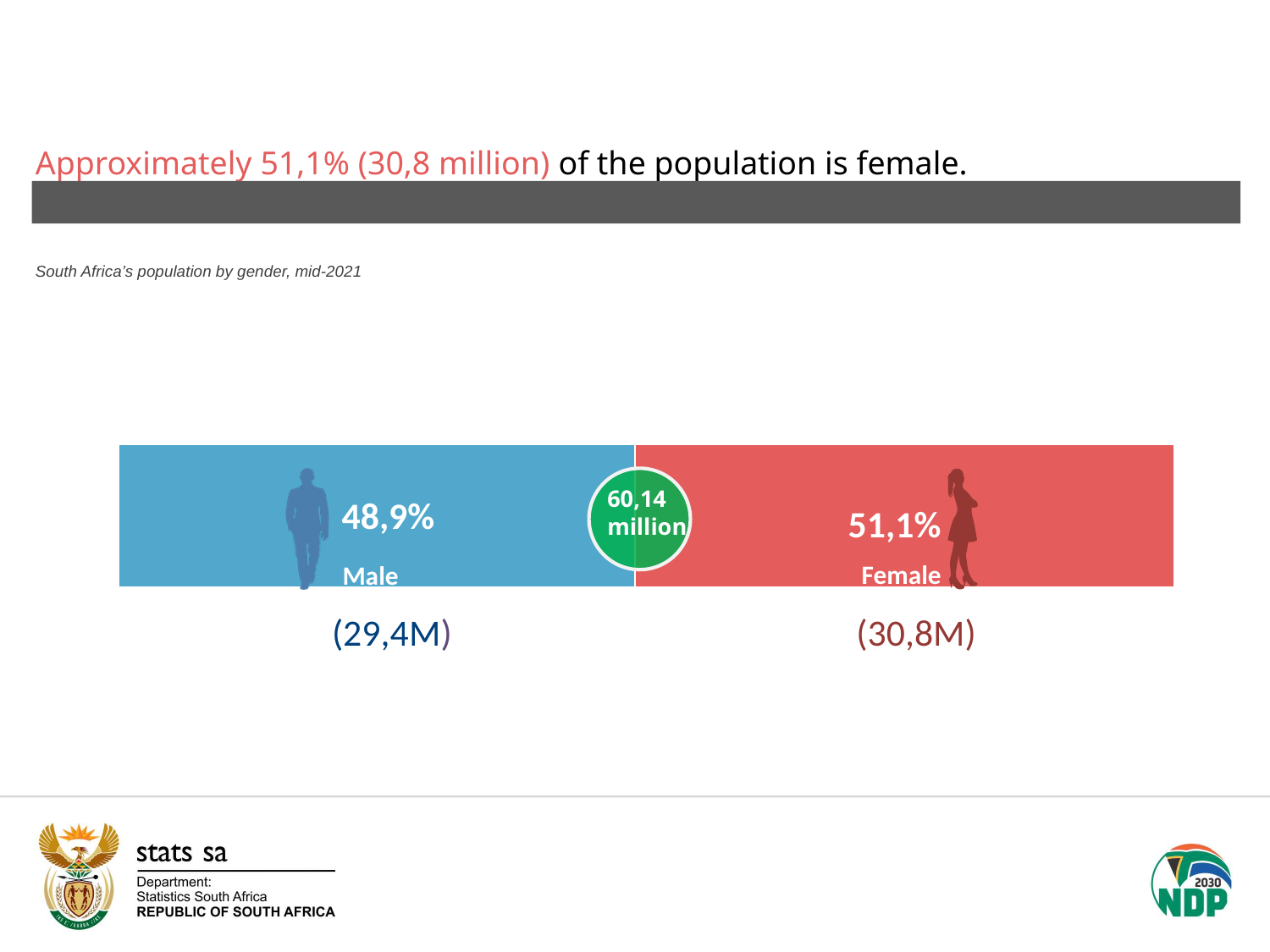
What is the title of the chart? South Africa's population by gender, mid-2021 Which gender group makes up the larger share of the population? Female What kind of chart is used to show the population by gender? Bar chart Which gender group makes up the smaller share of the population? Male What percentage of the population is female? 51,1% What is the total population shown in the centre of the bar? 60,14 million How many people are in the male group, as shown below the bar? 29,4M How many people are in the female group, as shown below the bar? 30,8M How many gender categories are shown in the bar? 2 What percentage of the population is male? 48,9% By how many million does the female population exceed the male population? 1,4M What is the difference in percentage points between the female and male shares? 2,2%